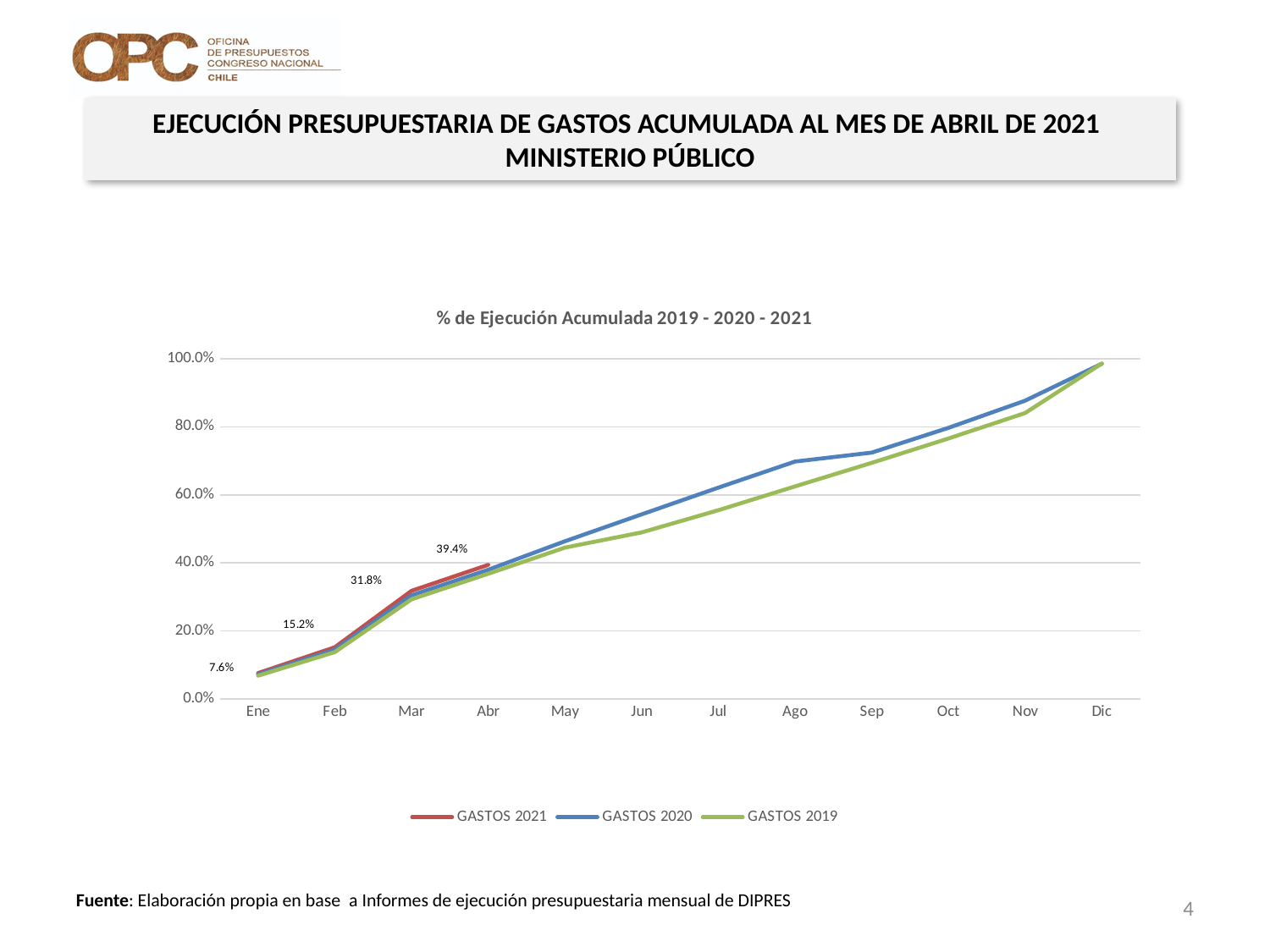
What is the value of GASTOS 2021 in Feb? 15.2% What is the difference between the GASTOS 2021 values for Mar and Feb? 16.6% What is the value of GASTOS 2021 in Ene? 7.6% How many series does the legend list? 3 What kind of chart is shown on the slide? Line chart Which series has the higher value in Ago, GASTOS 2020 or GASTOS 2019? GASTOS 2020 What is the value of GASTOS 2021 in Mar? 31.8% Is the value for GASTOS 2020 in Ago greater or less than 60.0%? greater By how much did GASTOS 2021 increase from Mar to Abr? 7.6% How many months are shown on the x axis? 12 Do the GASTOS 2020 values rise or fall from Ene to Dic? Rise What is the value of GASTOS 2021 in Abr? 39.4%